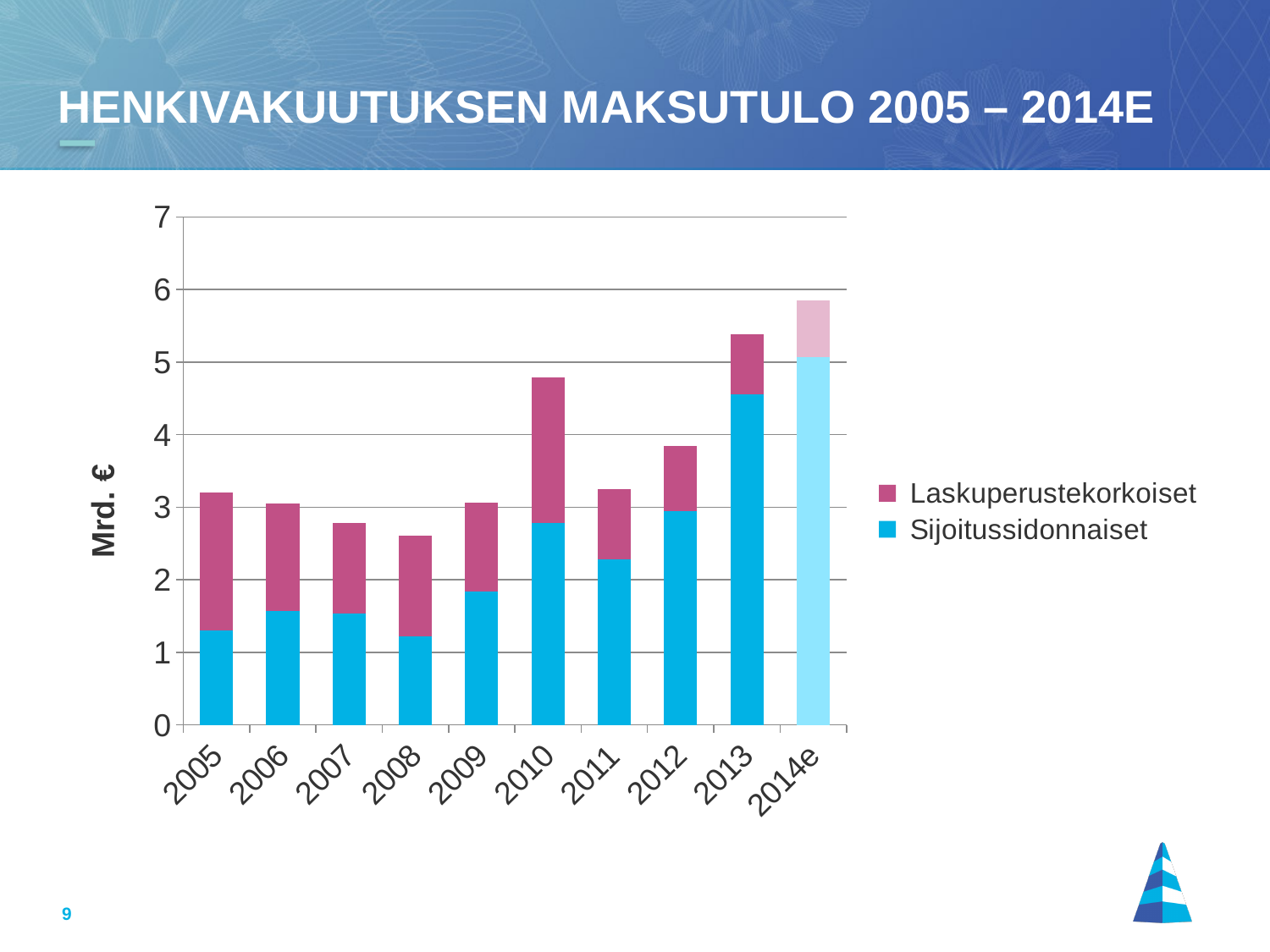
How many series does the legend list? 2 How many years (categories) are shown on the x axis? 10 Which year has the larger total bar, 2010 or 2012? 2010 What kind of chart is shown on the slide? Stacked bar chart Is the total bar for 2008 greater or less than 3? less Is the Sijoitussidonnaiset value for 2010 greater or less than 3? less Do the total bars rise or fall from 2011 to 2014e? rise Is the total bar for 2013 greater or less than 5? greater Which year has the lowest total bar? 2008 What is the label on the vertical axis? Mrd. € Which year has the highest total bar? 2014e